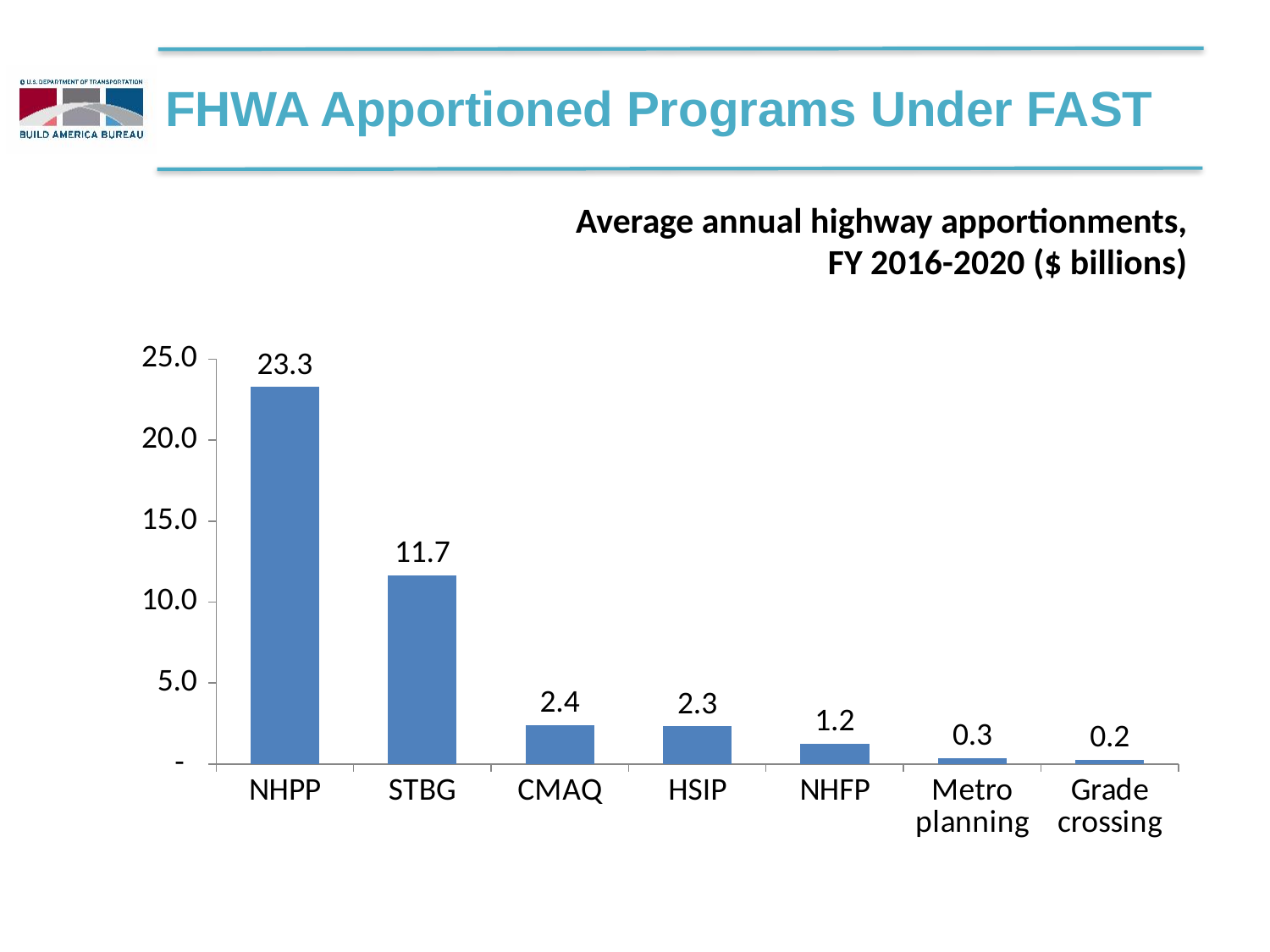
What is the difference between the values for NHPP and STBG? 11.6 What is the value shown for Metro planning? 0.3 How many programs are shown on the chart? 7 Which program has the highest average annual apportionment? NHPP Which program has the lowest average annual apportionment? Grade crossing Is the value for STBG greater or less than 10.0? greater What kind of chart is shown on the slide? Bar chart What is the average annual apportionment for NHPP? 23.3 Which has a larger value, HSIP or NHFP? HSIP What is the average annual apportionment for STBG? 11.7 What is the title of the chart? Average annual highway apportionments, FY 2016-2020 ($ billions) What is the difference between the values for CMAQ and NHFP? 1.2